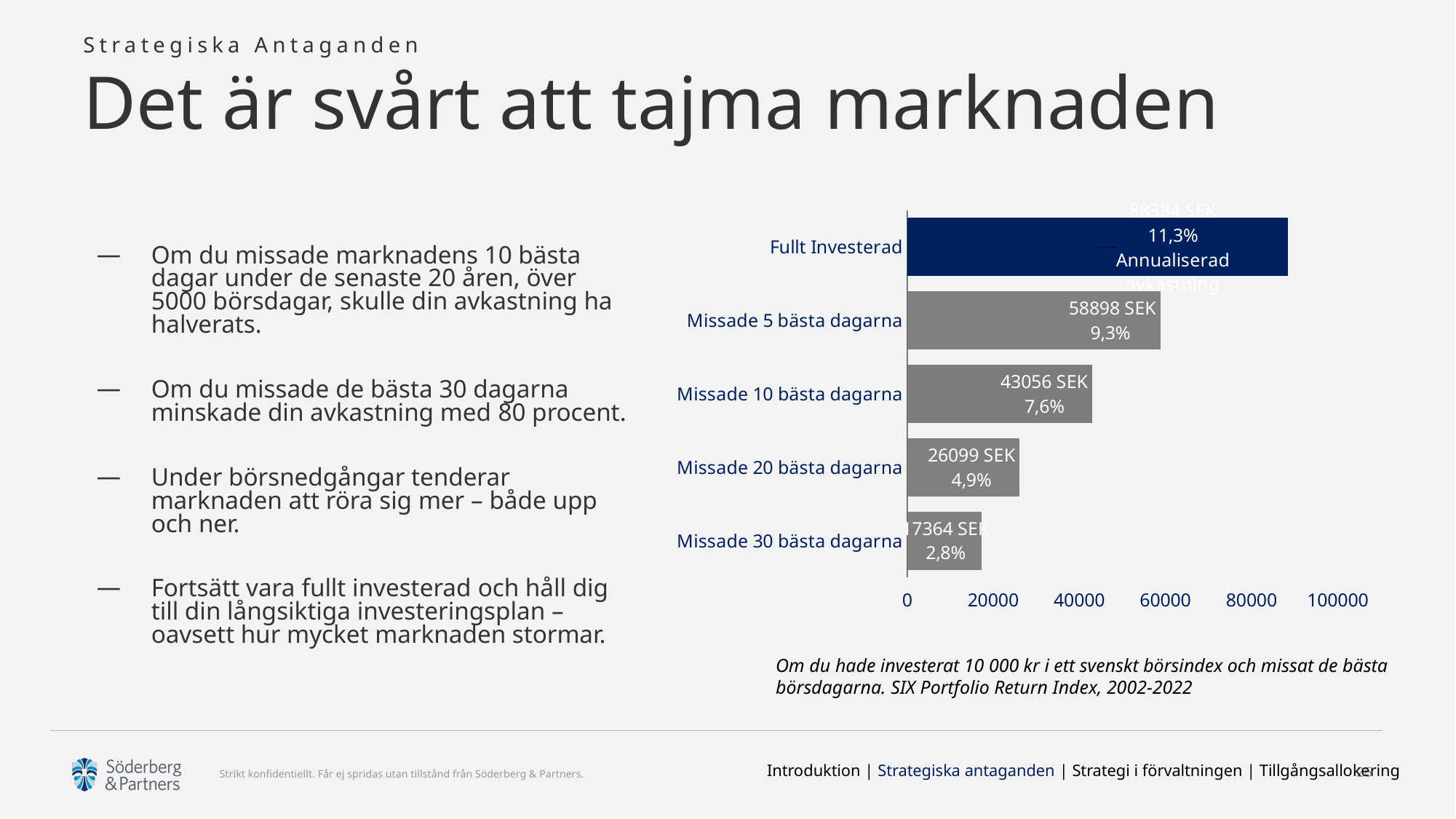
Do the values rise or fall as more of the best days are missed? fall Is the value for 'Fullt Investerad' greater or less than 80000? greater What is the value in SEK for 'Missade 20 bästa dagarna'? 26099 SEK What kind of chart is shown on the slide? bar chart What is the value in SEK for 'Missade 5 bästa dagarna'? 58898 SEK What is the difference in SEK between 'Missade 5 bästa dagarna' and 'Missade 10 bästa dagarna'? 15842 SEK What annualised return is shown for 'Fullt Investerad'? 11,3% How many categories does the bar chart show? 5 What annualised return is shown for 'Missade 30 bästa dagarna'? 2,8% What annualised return is shown for 'Missade 10 bästa dagarna'? 7,6% Which category has the lowest value? Missade 30 bästa dagarna Which category has the highest value? Fullt Investerad